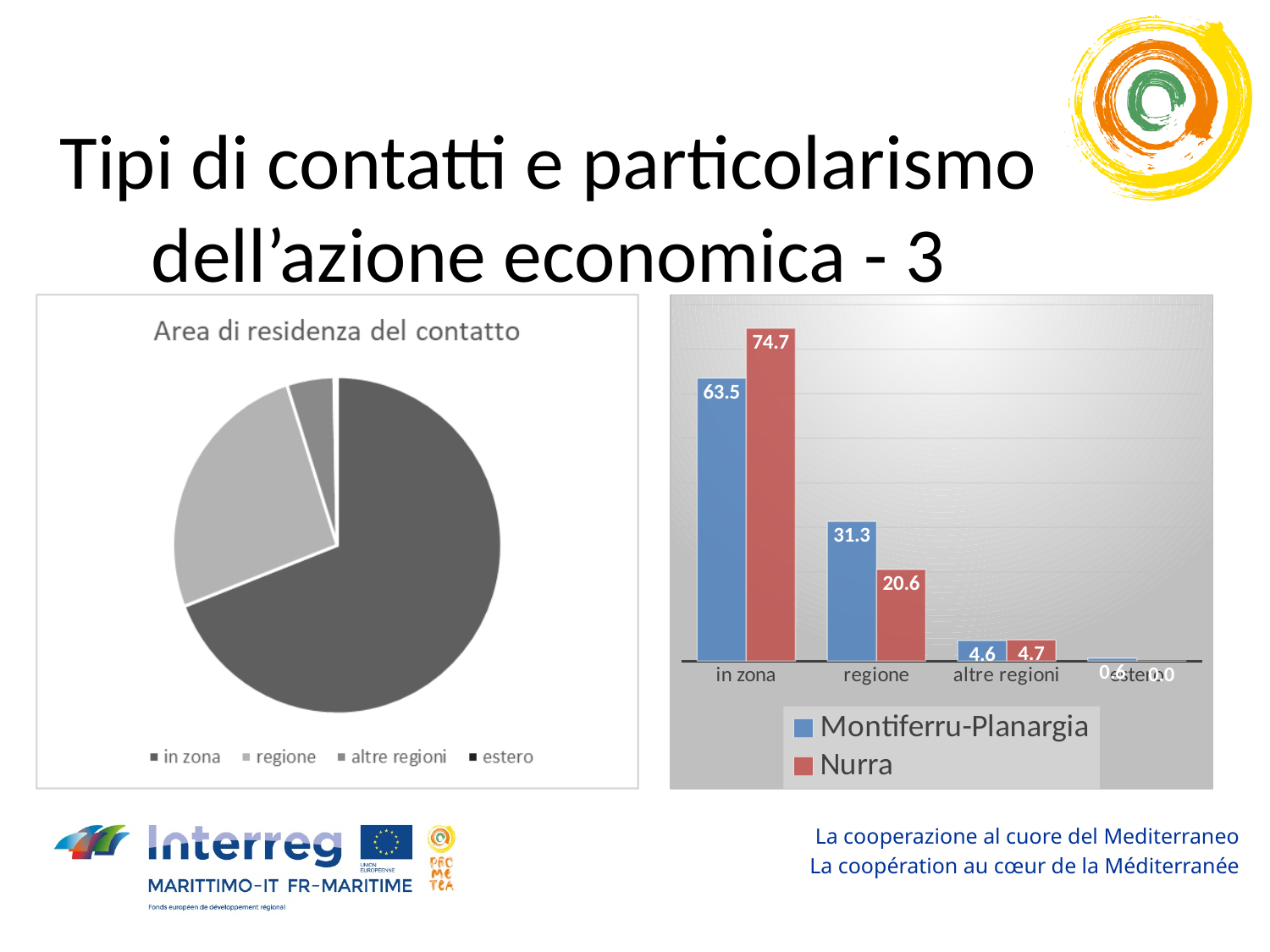
How many series does the legend of the bar chart on the right list? 2 In the bar chart on the right, what is the value for Montiferru-Planargia in the 'in zona' category? 63.5 In the bar chart on the right, which category has the highest value for Nurra? in zona What kind of chart is the chart on the left of the slide? pie chart In the bar chart on the right, what is the difference between the Nurra and Montiferru-Planargia values for 'in zona'? 11.2 In the bar chart on the right, what is the value for Nurra in the 'in zona' category? 74.7 In the bar chart on the right, what is the value for Montiferru-Planargia in the 'regione' category? 31.3 In the pie chart 'Area di residenza del contatto', which category has the largest slice? in zona In the bar chart on the right, what is the difference between the Montiferru-Planargia and Nurra values for 'regione'? 10.7 How many categories are shown on the x axis of the bar chart on the right? 4 In the bar chart on the right, what is the value for Nurra in the 'altre regioni' category? 4.7 In the bar chart on the right, which series has the larger value for 'regione', Montiferru-Planargia or Nurra? Montiferru-Planargia